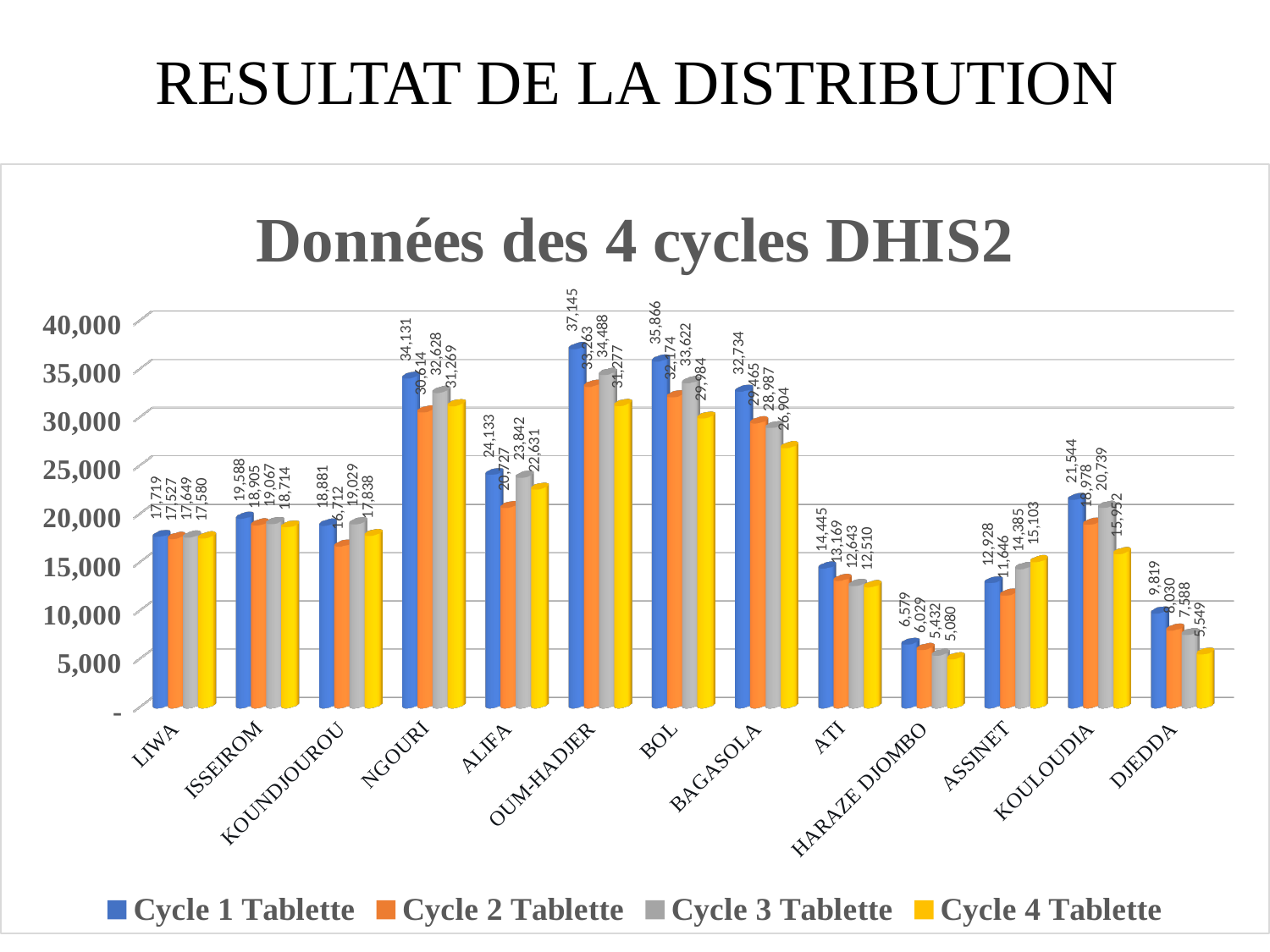
What kind of chart is shown on the slide? bar chart Which is larger for ASSINET: the Cycle 1 Tablette value or the Cycle 4 Tablette value? Cycle 4 Tablette What is the Cycle 1 Tablette value for OUM-HADJER? 37,145 What is the Cycle 3 Tablette value for ASSINET? 14,385 Which category has the lowest Cycle 4 Tablette value? HARAZE DJOMBO How many series does the legend list? 4 How many categories are shown on the x axis? 13 Which category has the highest Cycle 1 Tablette value? OUM-HADJER Is the Cycle 3 Tablette value for BOL greater or less than 30,000? greater What is the difference between the Cycle 1 Tablette and Cycle 4 Tablette values for DJEDDA? 4,270 What is the Cycle 4 Tablette value for HARAZE DJOMBO? 5,080 What is the title of the chart? Données des 4 cycles DHIS2